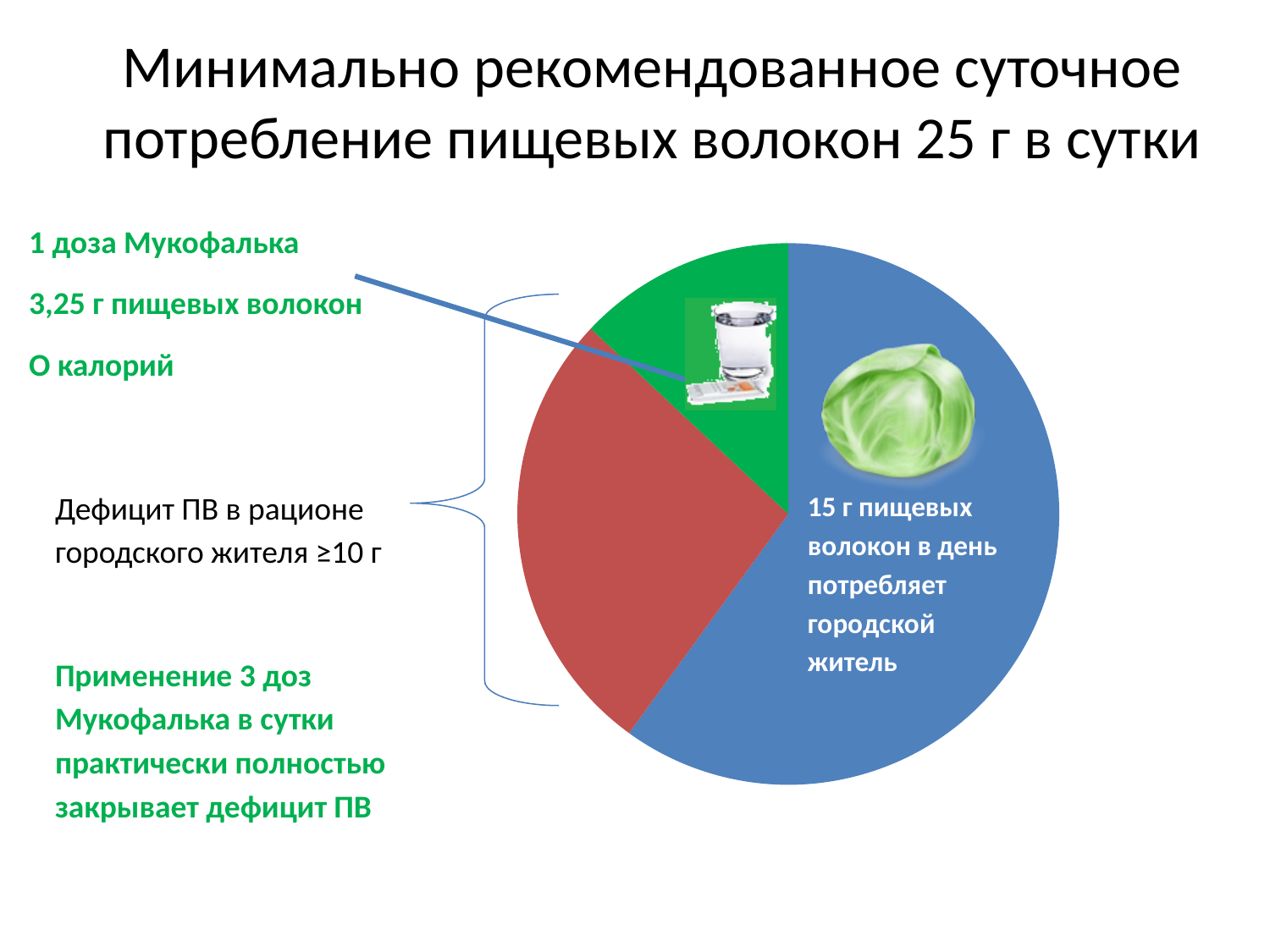
Which is larger, the red slice or the green slice? the red slice How many grams of dietary fibre does one dose of Мукофальк (the green slice) contain? 3,25 г What share of the 25 г daily recommendation does the 15 г consumed by a city dweller represent? 60% How many slices does the pie chart have? 3 How many grams of dietary fibre per day does the blue slice represent? 15 г Which is larger, the blue slice or the green slice? the blue slice Which slice of the pie chart is the largest? the blue slice (15 г пищевых волокон в день потребляет городской житель) Which slice of the pie chart is the smallest? the green slice (1 доза Мукофалька) What is the minimum recommended daily intake of dietary fibre stated in the slide title? 25 г в сутки How many calories does one dose of Мукофальк contain according to the slide? 0 калорий What kind of chart is shown on the slide? pie chart What colour is the slice labelled with the cabbage image and '15 г пищевых волокон в день'? blue